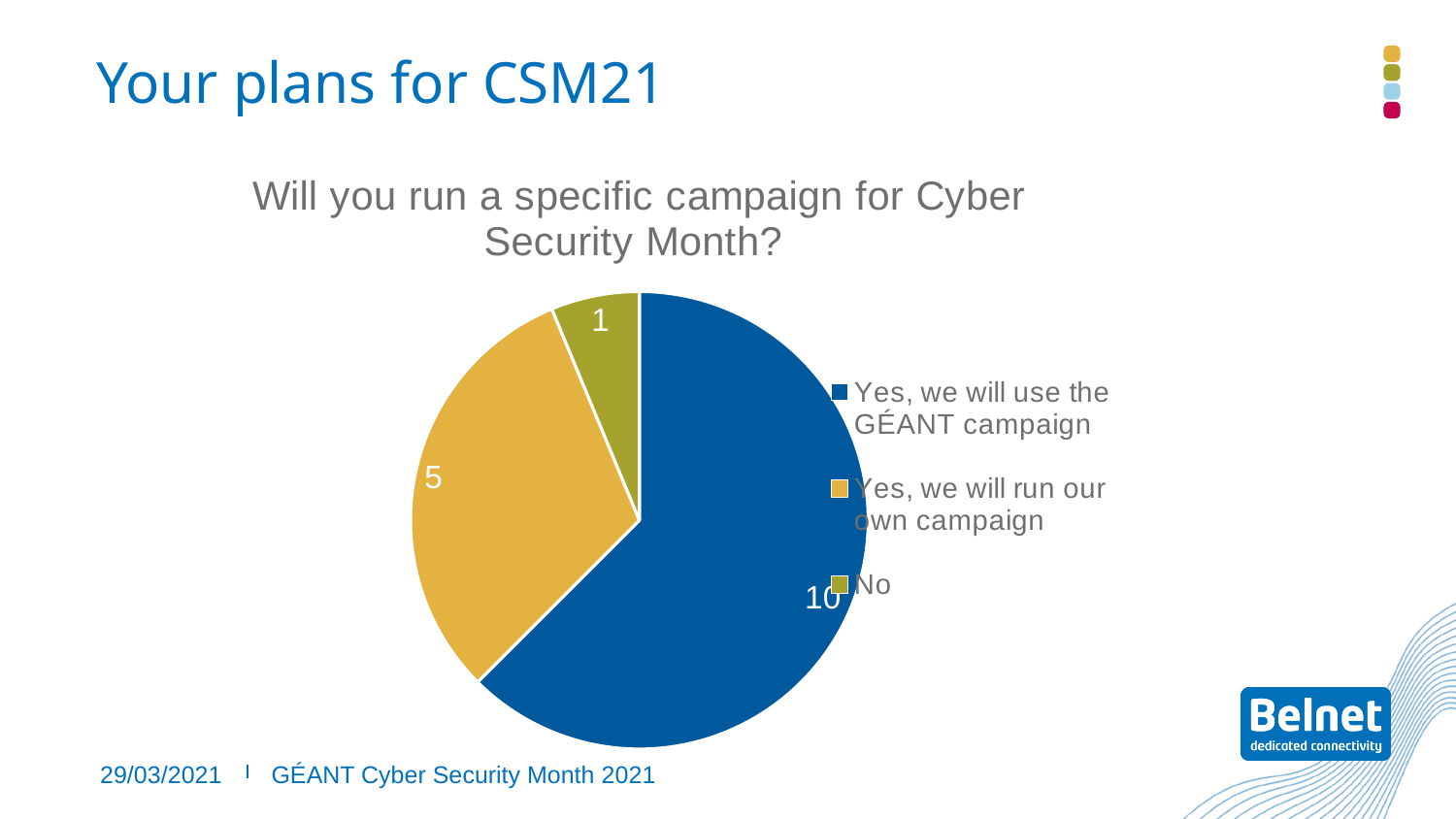
What is the value for "Yes, we will run our own campaign"? 5 What is the difference between the value for "Yes, we will use the GÉANT campaign" and the value for "Yes, we will run our own campaign"? 5 Which response has the smallest slice of the pie? No What is the total of all slices in the pie chart? 16 How many entries does the legend list? 3 What is the title of the chart? Will you run a specific campaign for Cyber Security Month? Which is larger: the value for "Yes, we will run our own campaign" or the value for "No"? Yes, we will run our own campaign Which response has the largest slice of the pie? Yes, we will use the GÉANT campaign What is the value for "Yes, we will use the GÉANT campaign"? 10 What kind of chart is shown on the slide? Pie chart What is the value for "No"? 1 How many slices does the pie chart have? 3